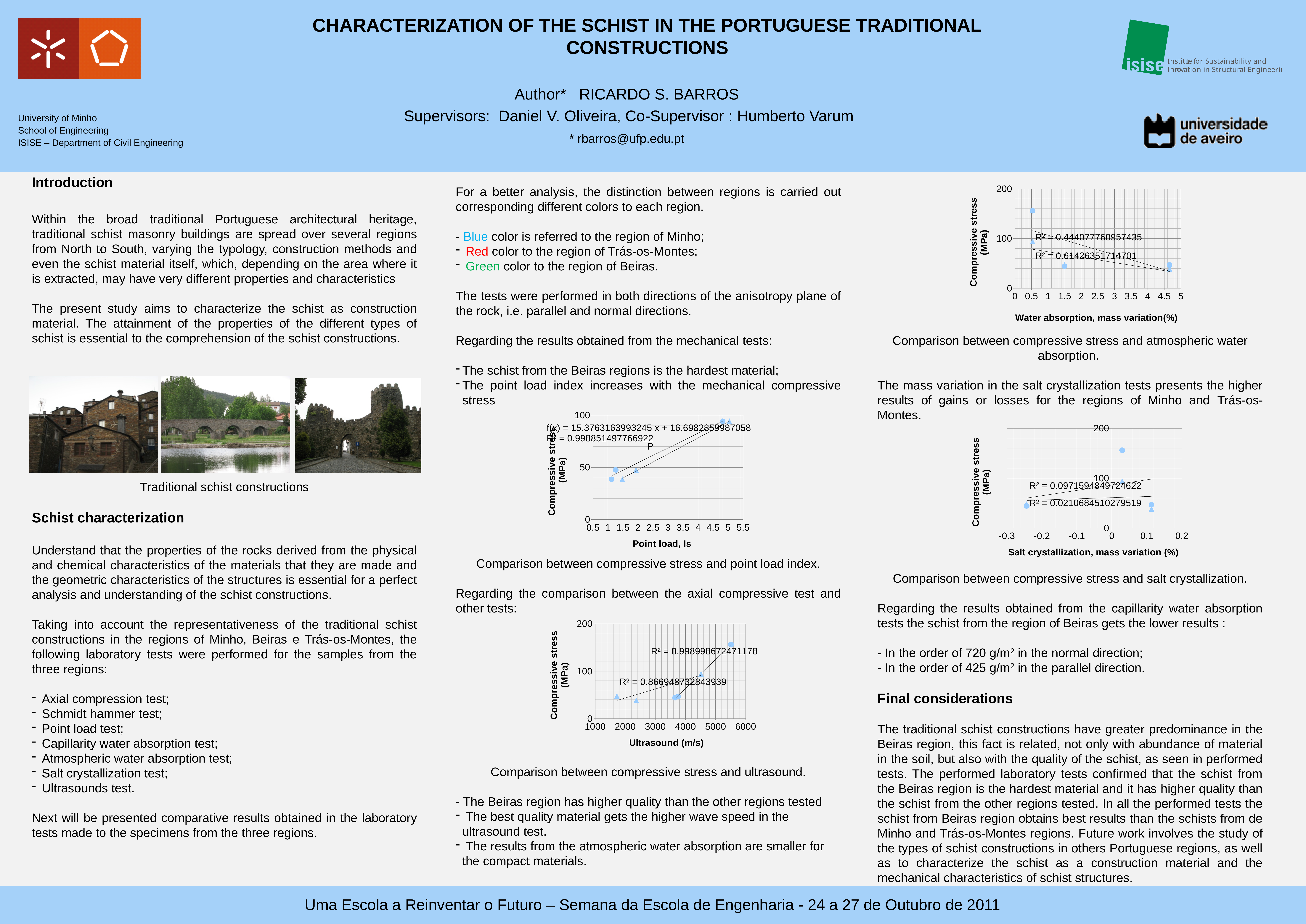
In the 'Comparison between compressive stress and ultrasound' chart, what is the lower of the two R² values printed? R² = 0.866948732843939 In the 'Comparison between compressive stress and point load index' chart, what R² value is printed? R² = 0.998851497766922 What kind of chart is the 'Comparison between compressive stress and point load index' chart? scatter chart In the 'Comparison between compressive stress and point load index' chart, what is the equation of the fitted line shown? f(x) = 15.3763163993245 x + 16.6982859987058 In the 'Comparison between compressive stress and point load index' chart, is the compressive stress of the point at about 5 on the point load axis greater or less than 50? greater In the 'Comparison between compressive stress and ultrasound' chart, is the compressive stress of the point at about 5500 m/s greater or less than 100? greater In the 'Comparison between compressive stress and ultrasound' chart, what is the higher of the two R² values printed? R² = 0.998998672471178 In the 'Comparison between compressive stress and salt crystallization' chart, what is the maximum value shown on the y axis? 200 In the 'Comparison between compressive stress and point load index' chart, what is the label of the x axis? Point load, Is In the 'Comparison between compressive stress and atmospheric water absorption' chart, what are the two R² values printed? R² = 0.444077760957435 and R² = 0.61426351714701 In the 'Comparison between compressive stress and salt crystallization' chart, what is the lower of the two R² values printed? R² = 0.0210684510279519